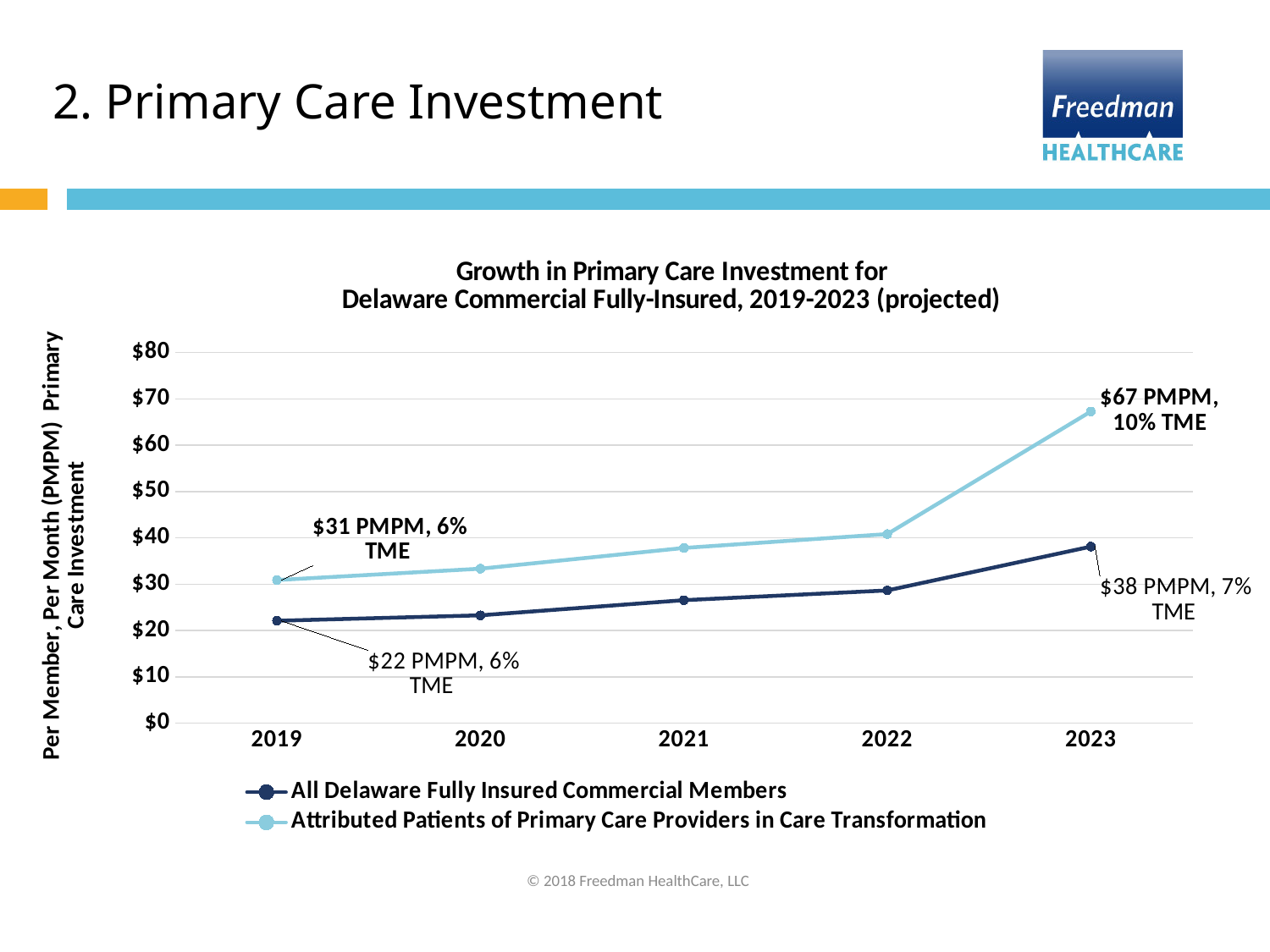
What type of chart is shown on the slide? Line chart How many years are shown on the x axis? 5 Do the values for All Delaware Fully Insured Commercial Members rise or fall from 2019 to 2023? rise What is the 2023 PMPM value for Attributed Patients of Primary Care Providers in Care Transformation? $67 PMPM What is the title of the chart? Growth in Primary Care Investment for Delaware Commercial Fully-Insured, 2019-2023 (projected) What is the 2019 PMPM value for Attributed Patients of Primary Care Providers in Care Transformation? $31 PMPM What is the difference between the 2023 values of the two series? $29 What percentage of TME does the 2019 value for All Delaware Fully Insured Commercial Members represent? 6% How many series does the legend list? 2 By how much does the Attributed Patients series grow from 2019 to 2023? $36 Is the 2022 value for Attributed Patients of Primary Care Providers in Care Transformation greater or less than $50? less What is the 2023 PMPM value for All Delaware Fully Insured Commercial Members? $38 PMPM